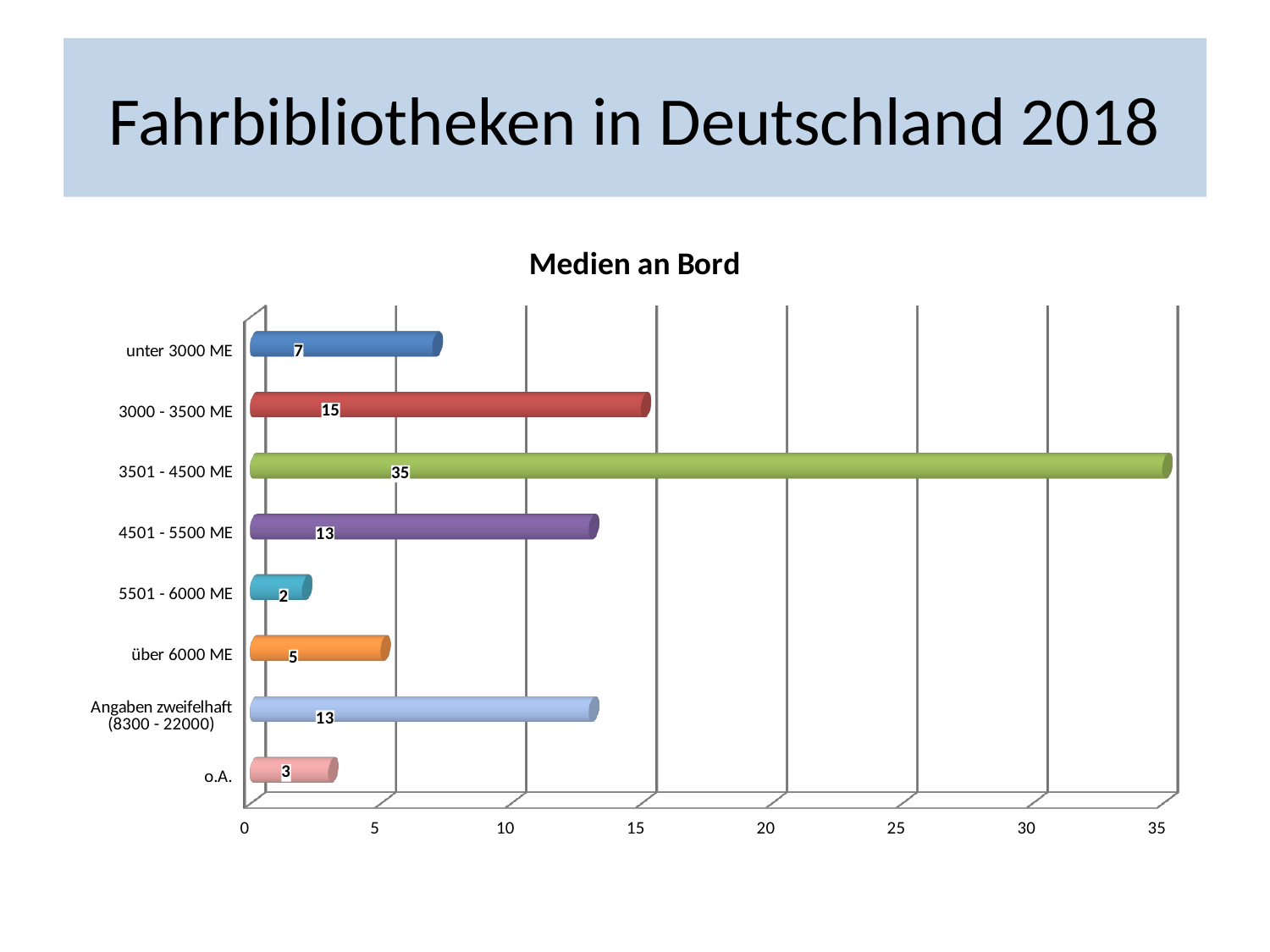
How many categories are shown in the chart? 8 Which category has the highest value? 3501 - 4500 ME What is the value for Angaben zweifelhaft (8300 - 22000)? 13 Which category has the lowest value? 5501 - 6000 ME What is the value for o.A.? 3 Which is larger, the value for 4501 - 5500 ME or the value for unter 3000 ME? 4501 - 5500 ME What is the value for 3501 - 4500 ME? 35 What is the difference between the values for 3000 - 3500 ME and über 6000 ME? 10 What is the value for unter 3000 ME? 7 What kind of chart is shown? bar chart What is the title of the chart? Medien an Bord Is the value for 3000 - 3500 ME greater or less than 10? greater